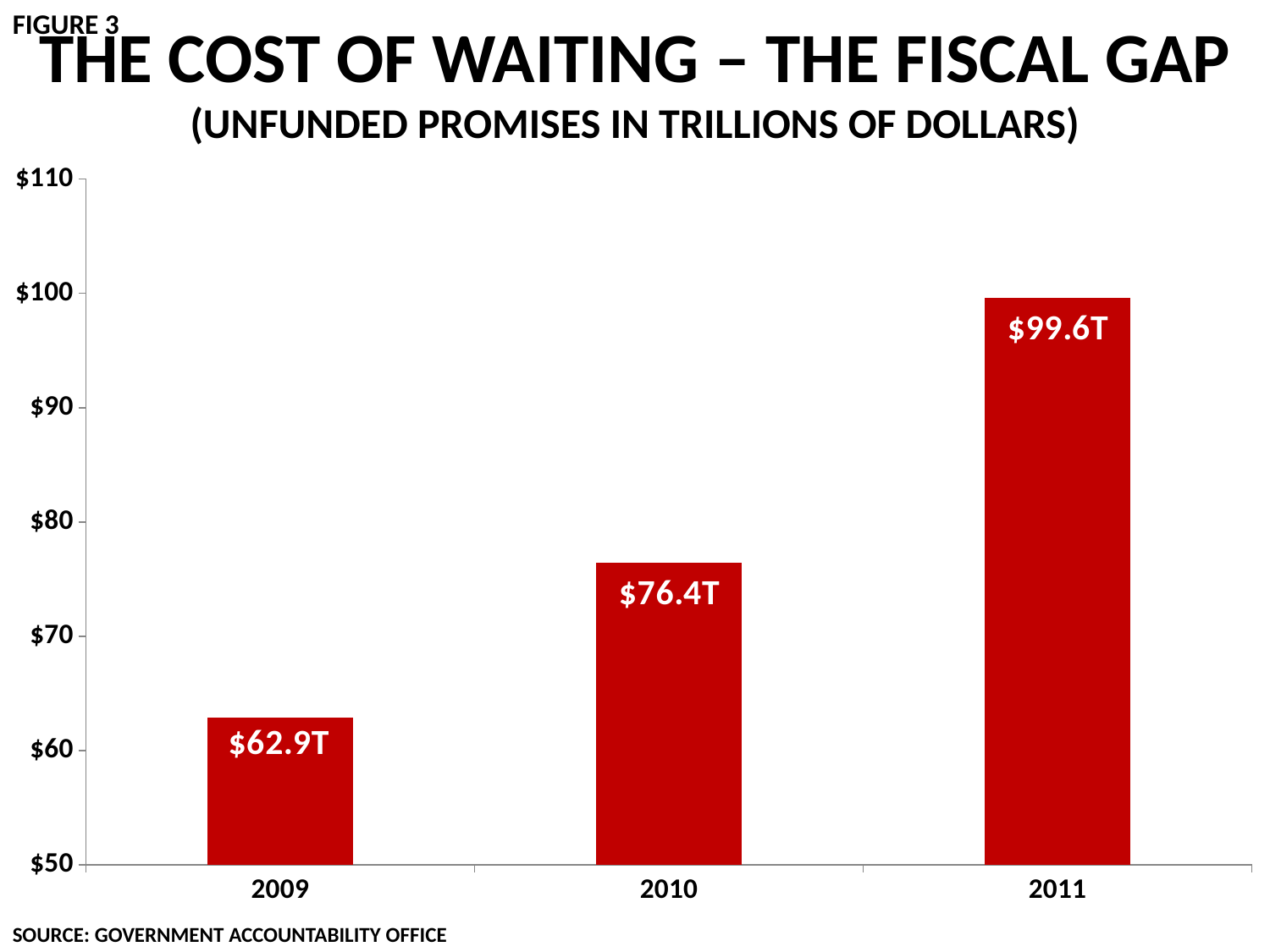
What is the value for 2011? $99.6T What is the difference between the values for 2010 and 2009? $13.5T What is the value for 2010? $76.4T What is the difference between the values for 2011 and 2009? $36.7T What kind of chart is this? bar chart How many years are shown on the chart? 3 What is the value for 2009? $62.9T Do the values rise or fall from 2009 to 2011? rise Which year has the highest value? 2011 Which is larger, the value for 2010 or the value for 2011? 2011 Which year has the lowest value? 2009 Is the value for 2010 greater or less than $80? less